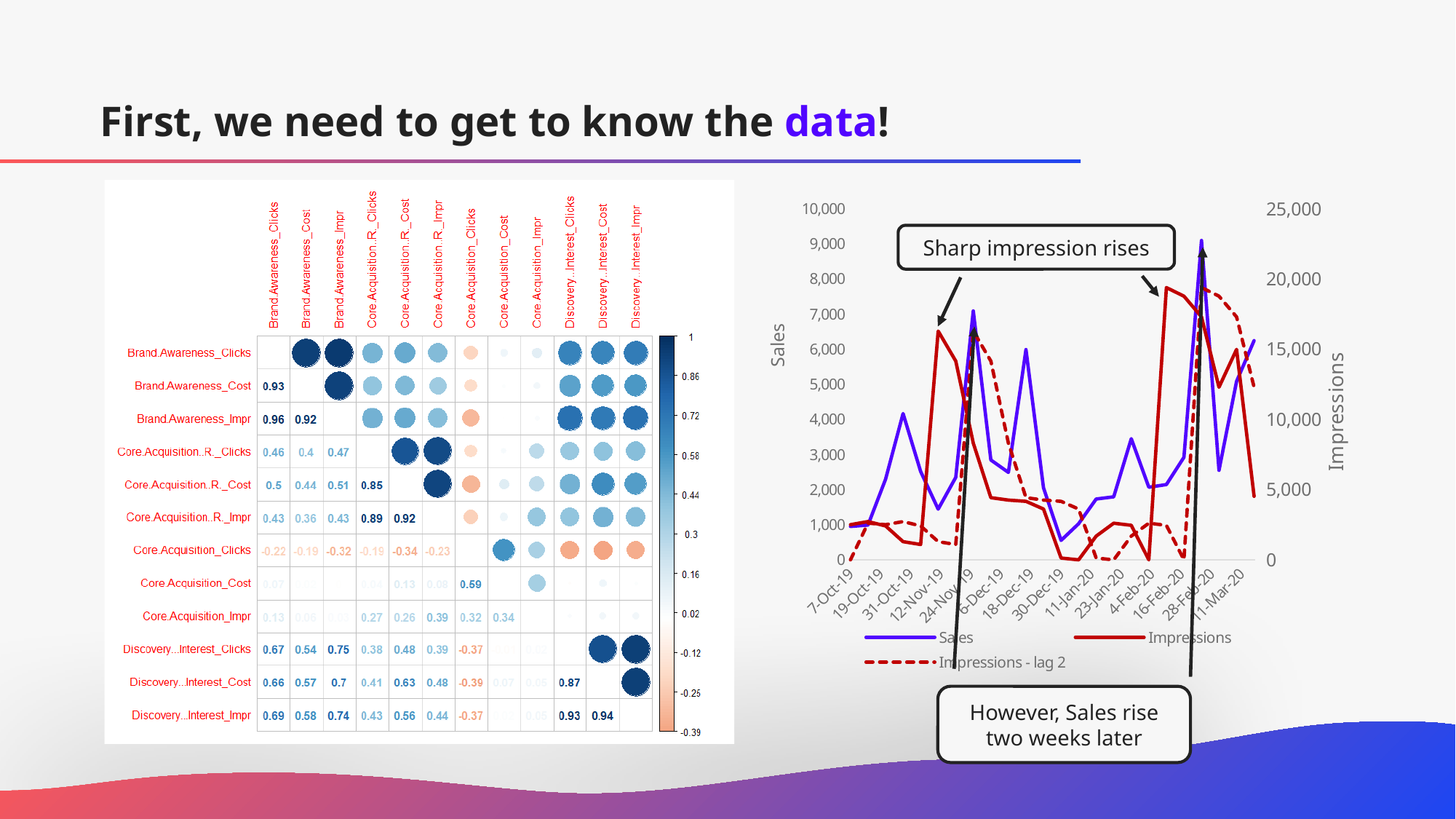
In the correlation matrix on the left, what is the correlation between Brand.Awareness_Cost and Brand.Awareness_Clicks? 0.93 What kind of chart is the chart on the right of the slide? Line chart In the line chart on the right, is the highest Sales value greater or less than 8,000? greater In the line chart on the right, is the highest Impressions value greater or less than 15,000? greater In the correlation matrix on the left, what is the correlation between Brand.Awareness_Impr and Brand.Awareness_Clicks? 0.96 In the correlation matrix on the left, how many variables are shown along each axis? 12 In the correlation matrix on the left, what is the correlation between Discovery...Interest_Impr and Discovery...Interest_Cost? 0.94 In the correlation matrix on the left, what is the correlation between Core.Acquisition_Cost and Core.Acquisition_Clicks? 0.59 In the line chart on the right, what is the title of the right-hand vertical axis? Impressions How many series does the legend of the line chart on the right list? 3 In the correlation matrix on the left, which is larger: the correlation of Discovery...Interest_Clicks with Brand.Awareness_Impr (0.75) or with Brand.Awareness_Cost (0.54)? Brand.Awareness_Impr (0.75) In the correlation matrix on the left, what is the correlation between Core.Acquisition_Clicks and Brand.Awareness_Impr? -0.32